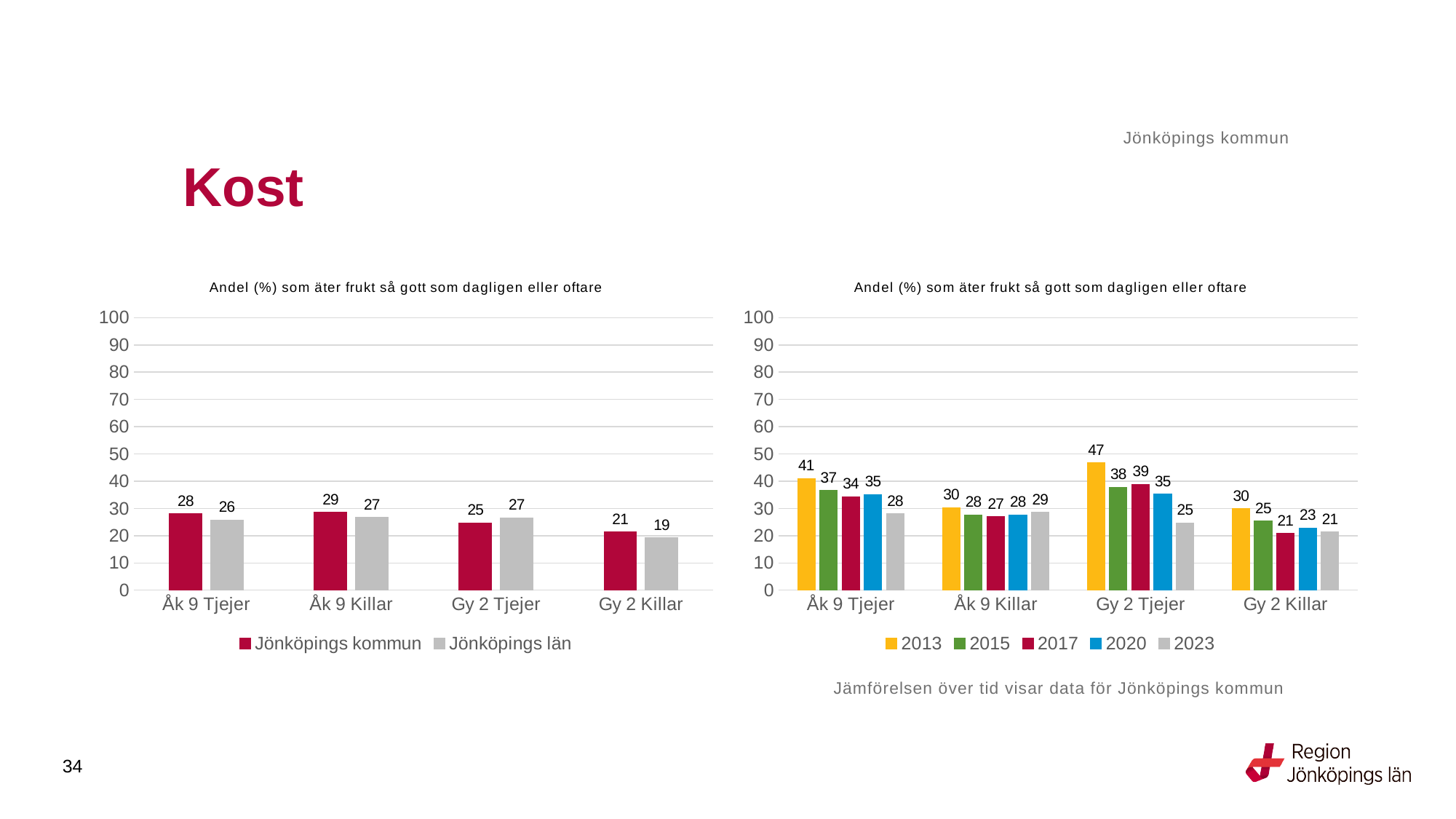
In the right chart, what is the value for 2023 for Åk 9 Killar? 29 In the right chart, which is larger for Gy 2 Killar: the 2015 value or the 2020 value? 2015 In the left chart, what is the value for Jönköpings län for Åk 9 Killar? 27 In the left chart, what is the value for Jönköpings kommun for Gy 2 Killar? 21 In the right chart, which category has the highest value for 2013? Gy 2 Tjejer In the left chart, what is the difference between Jönköpings kommun and Jönköpings län for Gy 2 Tjejer? 2 In the left chart, which category has the lowest value for Jönköpings län? Gy 2 Killar What kind of chart is the right chart? Bar chart In the left chart, how many series does the legend list? 2 In the right chart, what is the difference between the 2013 and 2023 values for Åk 9 Tjejer? 13 In the right chart, what is the value for 2013 for Gy 2 Tjejer? 47 In the right chart, how many series does the legend list? 5